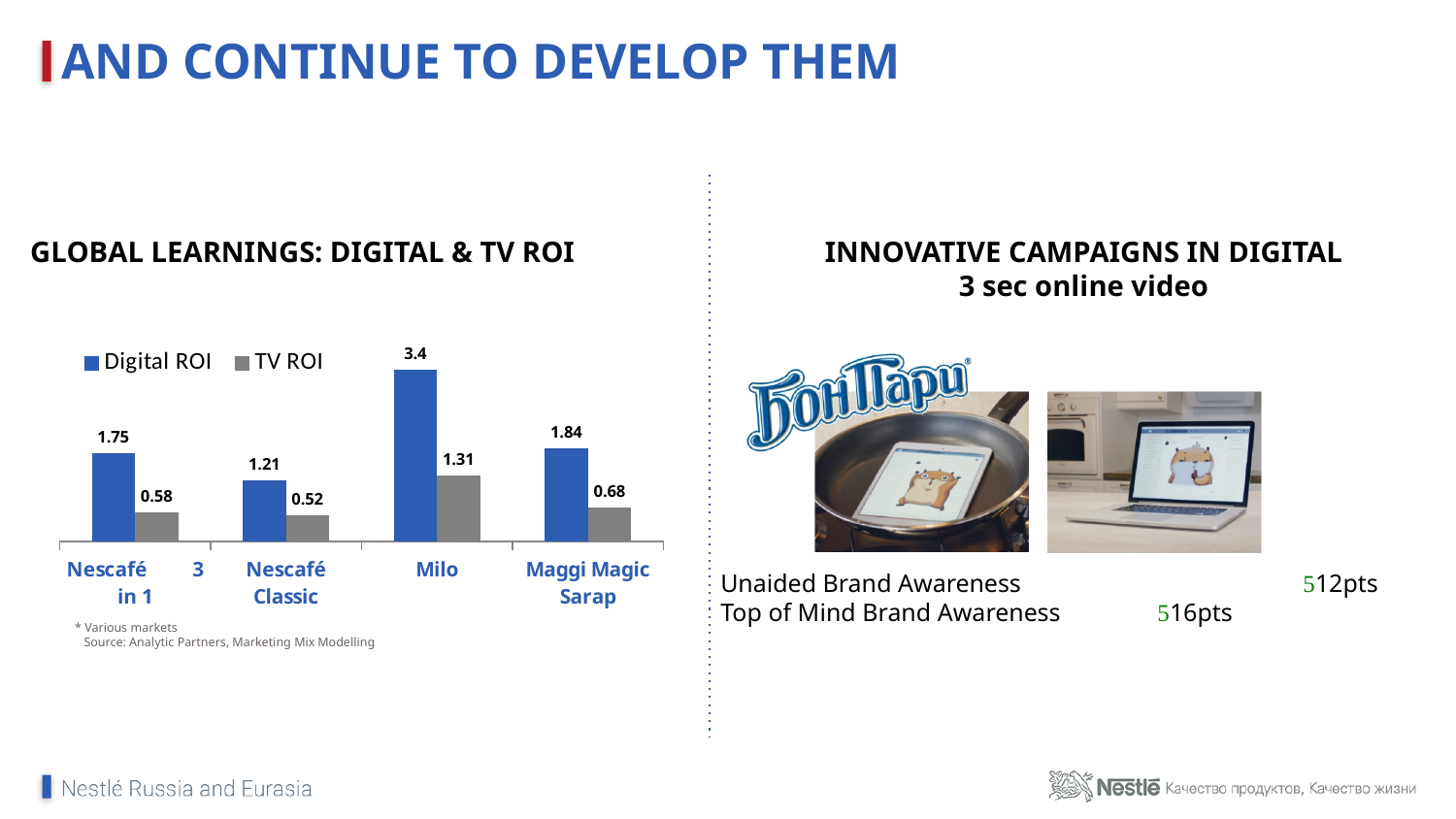
What is the TV ROI value for Nescafé 3 in 1? 0.58 What type of chart is used to show Digital & TV ROI? Bar chart Which category has the highest Digital ROI? Milo Which is larger, the Digital ROI for Nescafé 3 in 1 or the Digital ROI for Nescafé Classic? Nescafé 3 in 1 What is the Digital ROI value for Milo? 3.4 What is the TV ROI value for Nescafé Classic? 0.52 What colour represents Digital ROI in the chart? Blue How many series does the chart legend list? 2 How many categories are shown on the x axis of the chart? 4 What is the difference between the Digital ROI and TV ROI for Milo? 2.09 What is the Digital ROI value for Maggi Magic Sarap? 1.84 Which category has the lowest TV ROI? Nescafé Classic